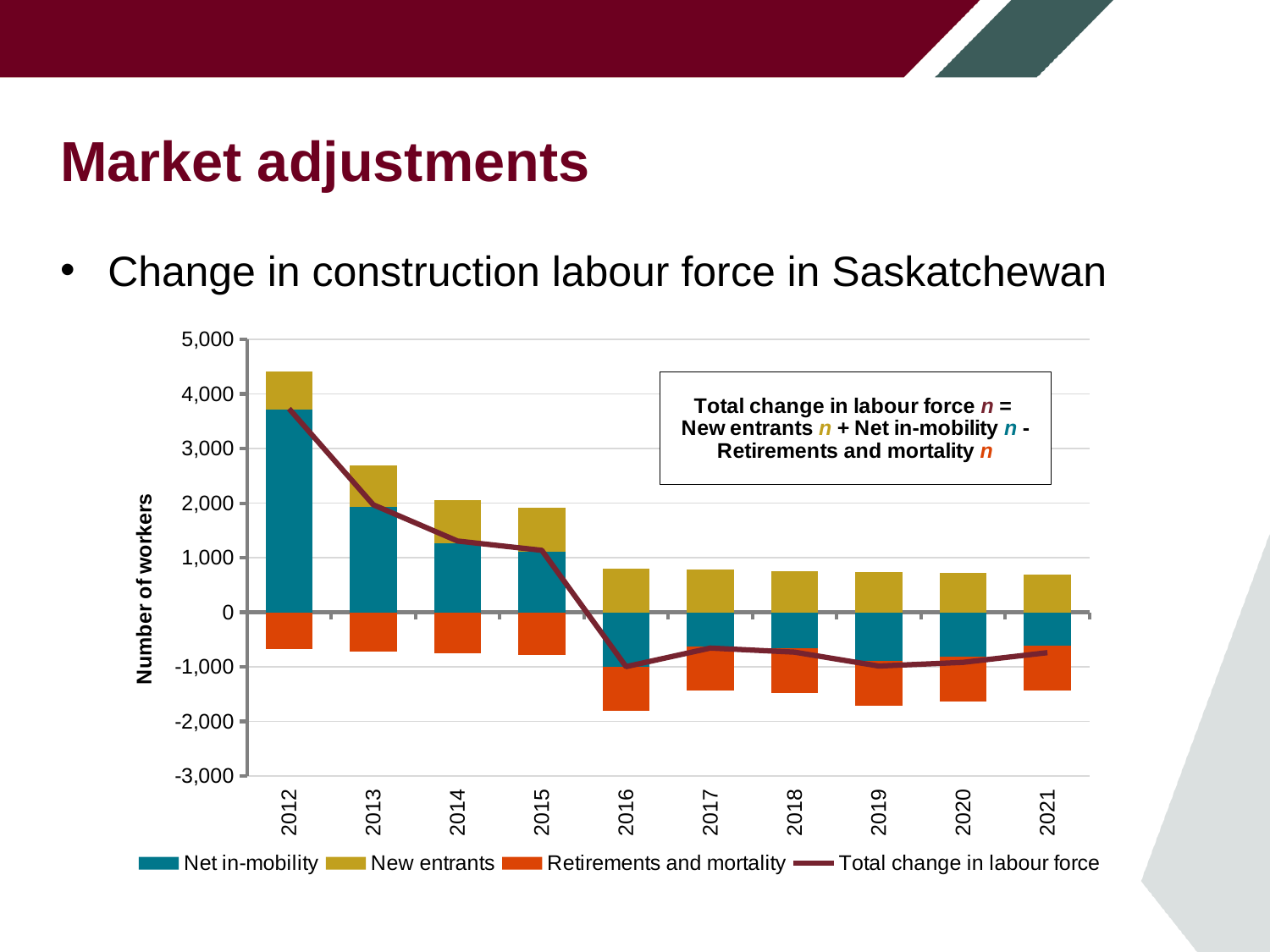
Does the Total change in labour force line rise or fall from 2012 to 2016? It falls Is the Net in-mobility value for 2013 greater or less than 1,000? greater Is the Total change in labour force for 2012 greater or less than 3,000? greater Which year has the larger Net in-mobility value, 2012 or 2013? 2012 Which series is drawn as a line rather than bars in the chart? Total change in labour force What is the title of the chart's vertical axis? Number of workers In which year is the Total change in labour force line at its highest? 2012 How many years are shown on the x axis of the chart? 10 In which year does the Retirements and mortality bar extend furthest below zero? 2016 Is the Total change in labour force for 2016 greater or less than 0? less What kind of chart is shown on the slide? A bar chart combined with a line How many series does the chart's legend list? 4